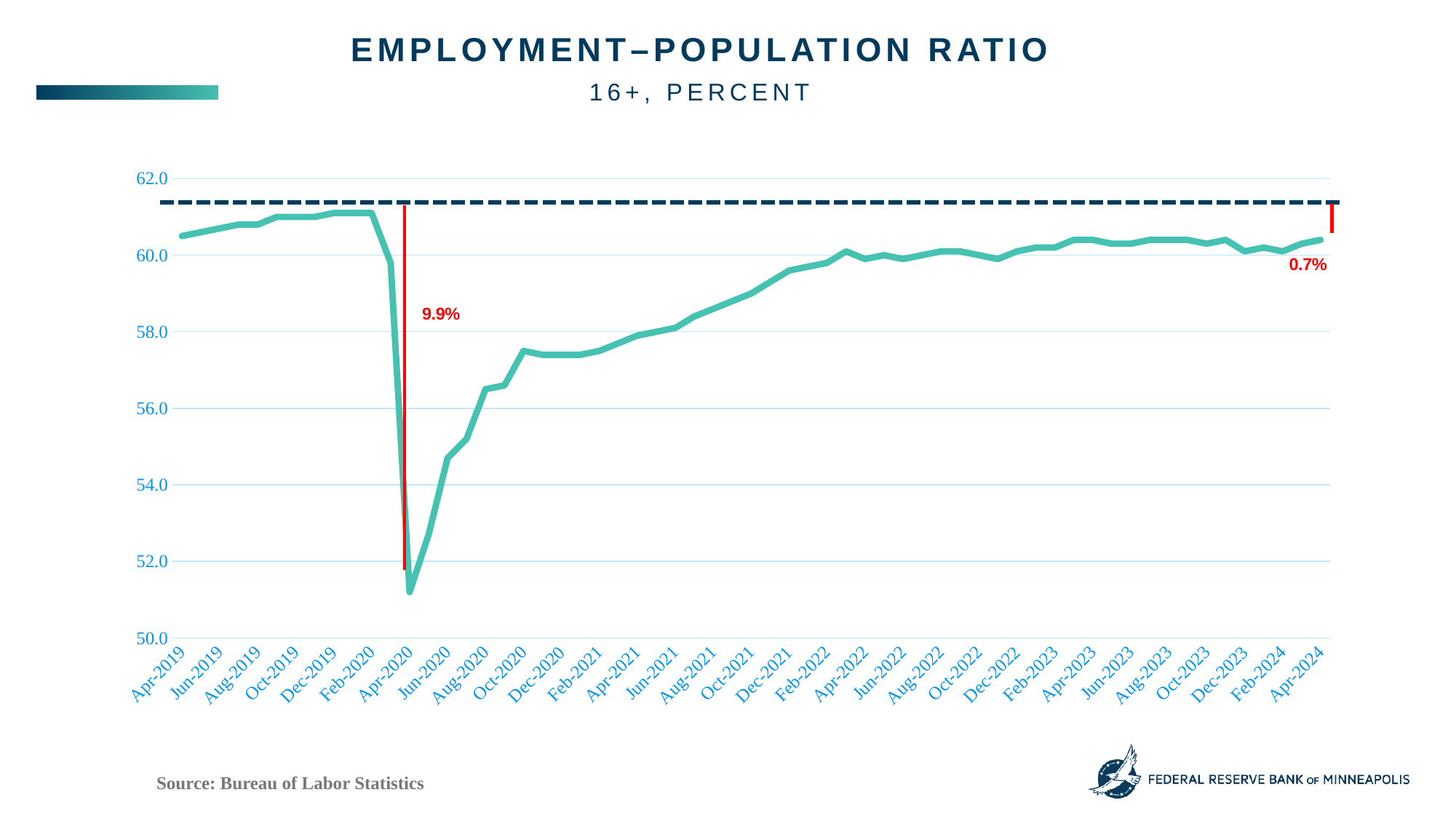
Does the employment–population ratio rise or fall between Apr-2020 and Apr-2022? rise Is the value for Apr-2024 greater or less than 60.0? greater What kind of chart is shown on the slide? line chart Which is larger, the value for Dec-2020 or the value for Dec-2021? Dec-2021 What percentage drop is annotated in red next to the vertical red line at Apr-2020? 9.9% What percentage gap is annotated in red at the right end of the chart near Apr-2024? 0.7% Is the value for Apr-2020 greater or less than 52.0? less Is the value for Apr-2019 greater or less than 60.0? greater In which month does the employment–population ratio reach its lowest point? Apr-2020 What is the title of the chart? EMPLOYMENT–POPULATION RATIO What source is cited for the chart data? Bureau of Labor Statistics